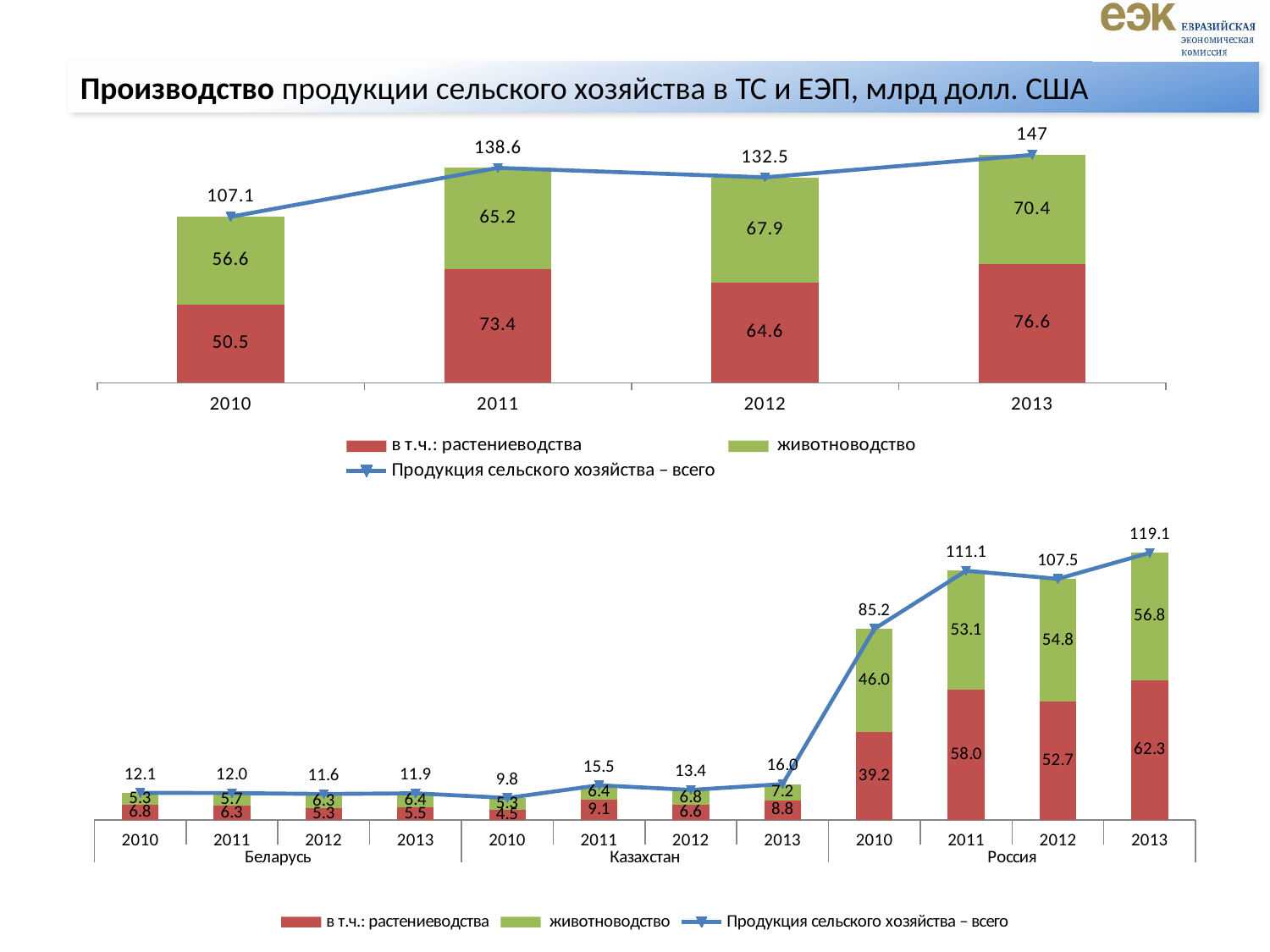
In the top chart, which is larger in 2012: растениеводства or животноводство? животноводство In the bottom chart, what is the value for растениеводства for Казахстан in 2011? 9.1 In the top chart, which year has the lowest total value? 2010 In the bottom chart, how many countries are shown on the x axis? 3 In the top chart, what is the value of the total line (Продукция сельского хозяйства – всего) for 2013? 147 What kind of chart is the bottom chart? Stacked bar chart with a line In the bottom chart, what is the total value for Россия in 2013? 119.1 In the bottom chart, which year has the highest total value for Казахстан? 2013 In the top chart, what is the value for животноводство in 2012? 67.9 How many series does the legend of the top chart list? 3 In the top chart, what is the value for растениеводства in 2011? 73.4 In the top chart, what is the difference between the total values for 2011 and 2010? 31.5